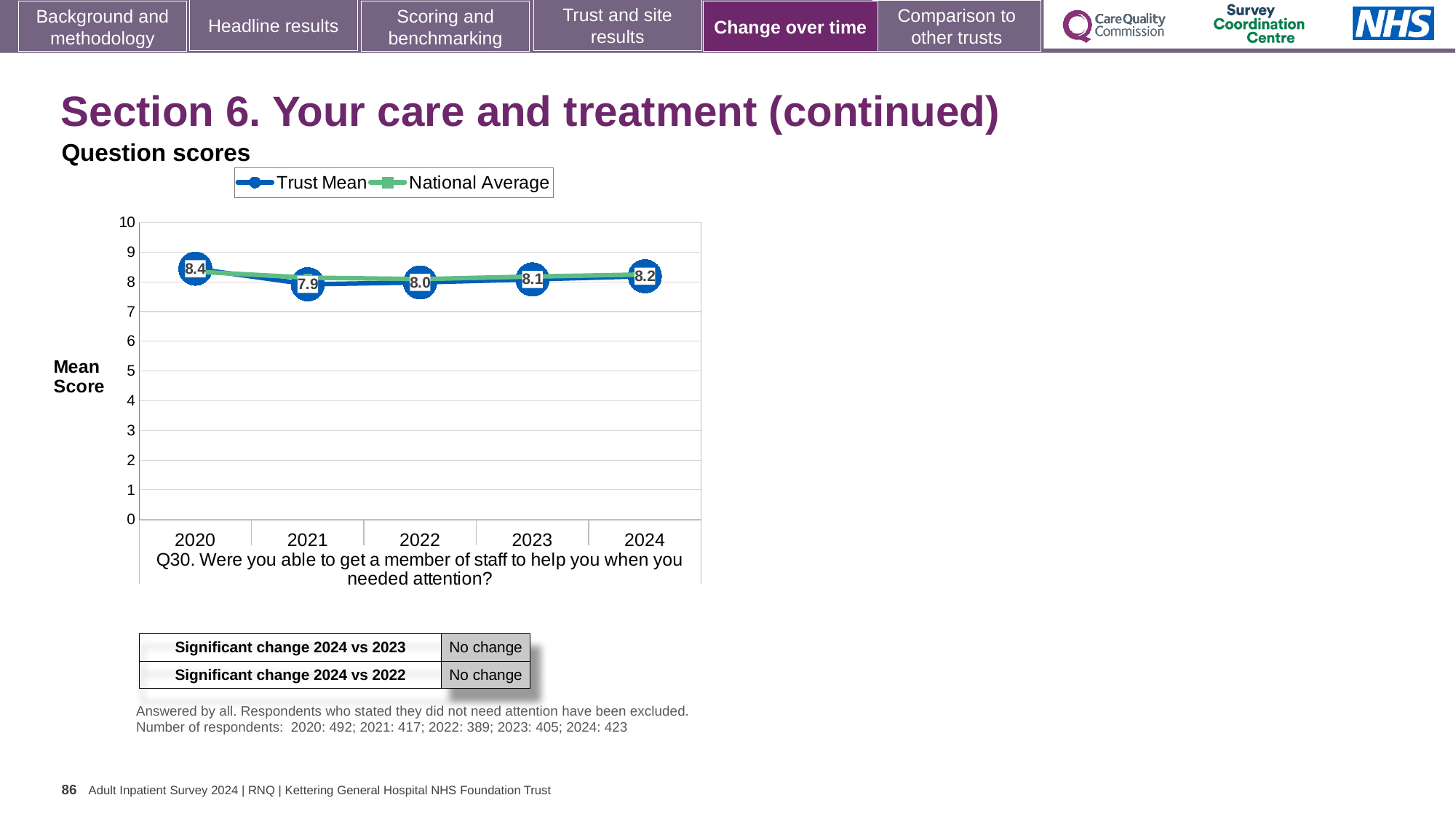
In which year is the Trust Mean score lowest? 2021 Is the National Average value for 2022 greater or less than 5? greater Which is larger, the Trust Mean score for 2023 or for 2022? 2023 What kind of chart is shown on the slide? Line chart Does the Trust Mean score rise or fall from 2021 to 2024? Rise What is the difference between the Trust Mean score in 2020 and in 2021? 0.5 How many years are plotted on the x axis? 5 In which year is the Trust Mean score highest? 2020 What is the Trust Mean score for 2024? 8.2 What is the Trust Mean score for 2021? 7.9 What is the Trust Mean score for 2020? 8.4 How many series does the legend list? 2